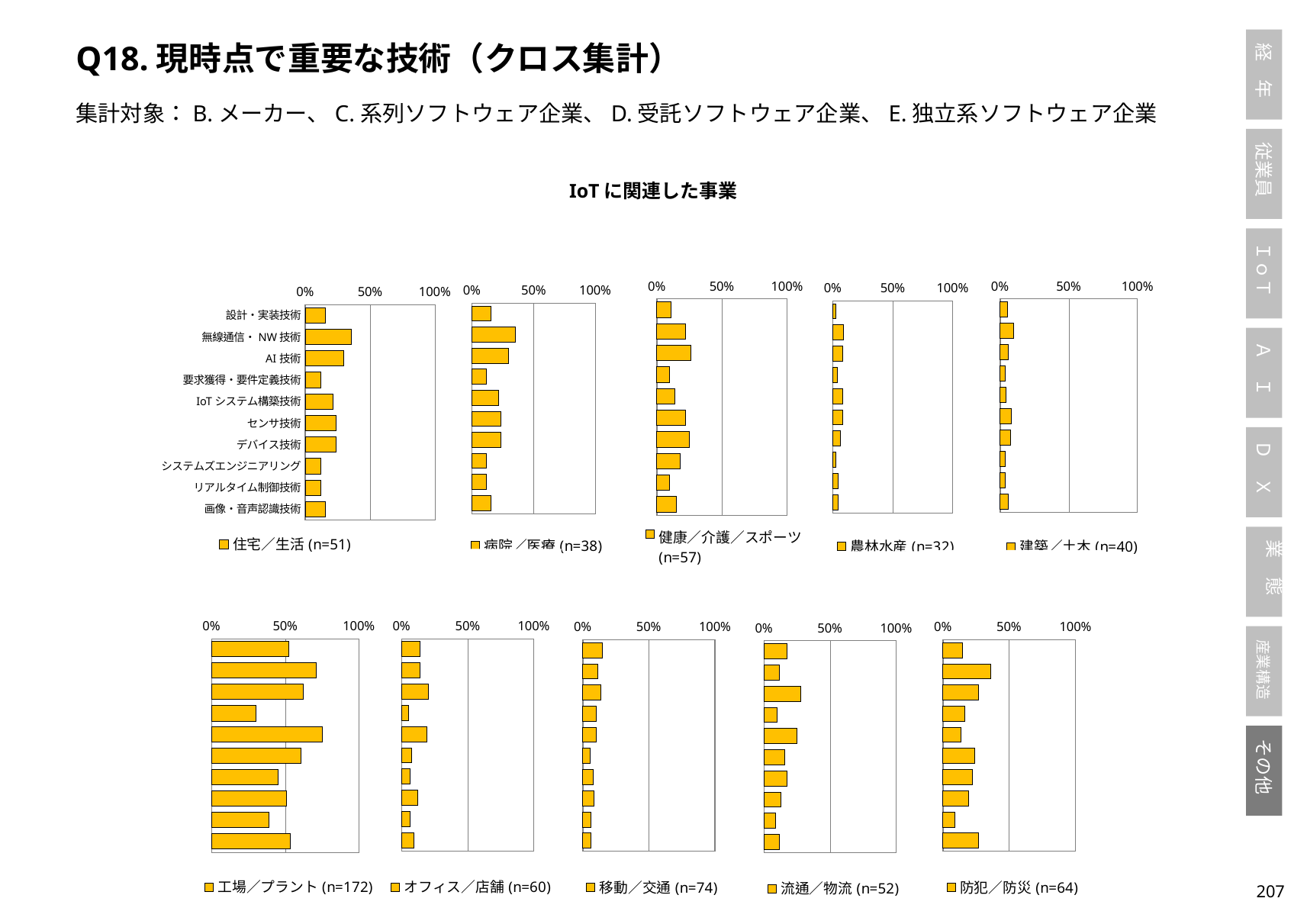
What kind of chart is used for the 工場／プラント (n=172) panel? bar chart In the 工場／プラント (n=172) chart, is the value for IoTシステム構築技術 greater or less than 50%? greater How many technology categories are listed on the vertical axis of the 住宅／生活 (n=51) chart? 10 In the 工場／プラント (n=172) chart, is the value for 要求獲得・要件定義技術 greater or less than 50%? less How many series does the legend of the 病院／医療 (n=38) chart list? 1 In the 住宅／生活 (n=51) chart, is the value for 無線通信・NW技術 greater or less than 50%? less In the 工場／プラント (n=172) chart, which technology has the lowest value? 要求獲得・要件定義技術 In the 工場／プラント (n=172) chart, which is larger: 無線通信・NW技術 or 要求獲得・要件定義技術? 無線通信・NW技術 In the 住宅／生活 (n=51) chart, which is larger: 無線通信・NW技術 or システムズエンジニアリング? 無線通信・NW技術 What is the common title shown above the group of charts? IoT に関連した事業 What sample size (n) is shown in the legend of the 工場／プラント chart? 172